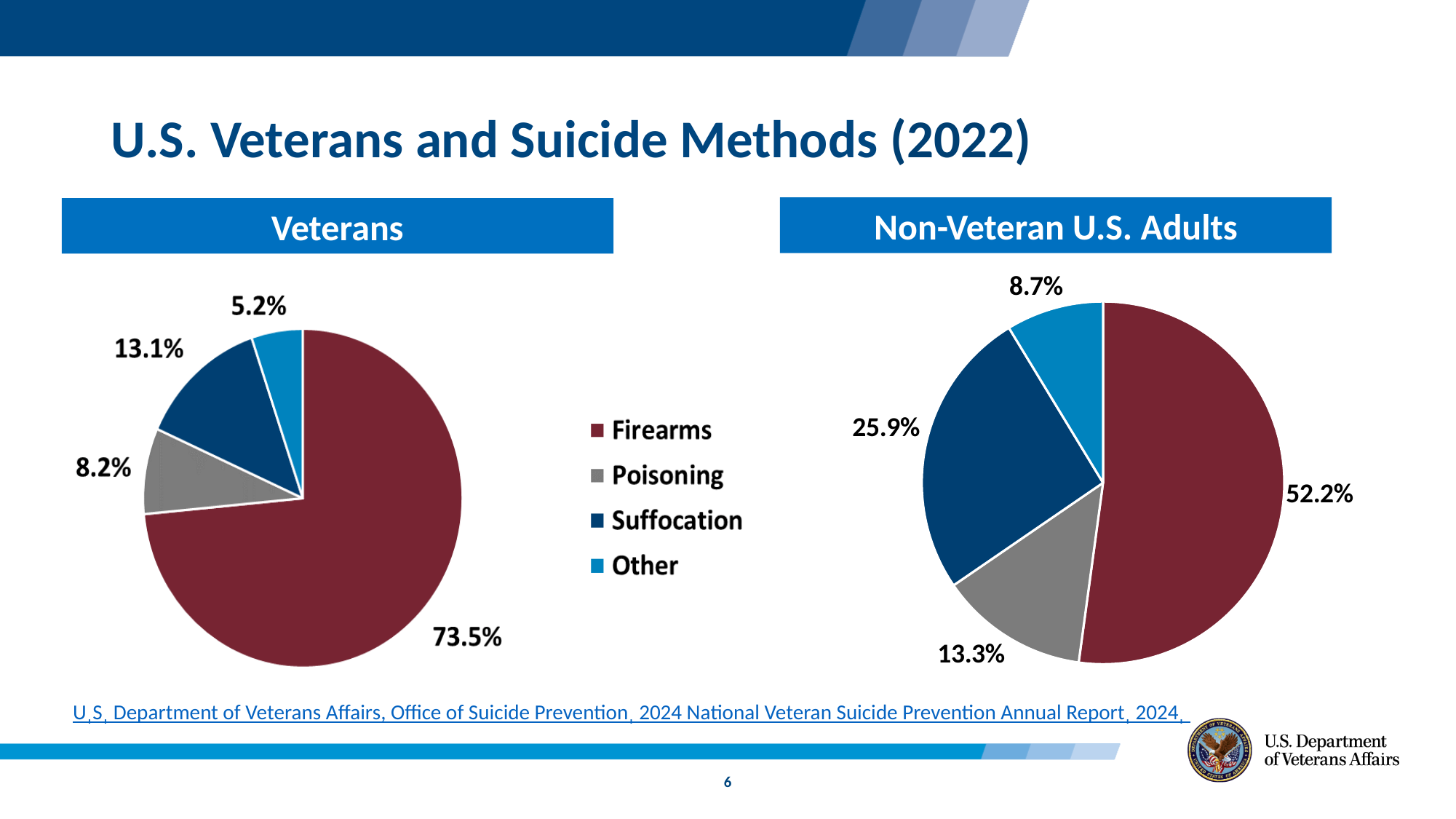
What type of chart is used for the Non-Veteran U.S. Adults data? Pie chart What is the difference between the Firearms share in the Veterans chart and the Firearms share in the Non-Veteran U.S. Adults chart? 21.3% In the Veterans pie chart, which method has the smallest slice? Other Which colour represents Poisoning in the legend? Gray Which is larger: the Suffocation share for Veterans or the Suffocation share for Non-Veteran U.S. Adults? Non-Veteran U.S. Adults How many slices does the Veterans pie chart have? 4 In the Veterans pie chart, what share is Poisoning? 8.2% In the Veterans pie chart, which method has the largest slice? Firearms In the Non-Veteran U.S. Adults pie chart, what share is Other? 8.7% In the Non-Veteran U.S. Adults pie chart, what share is Suffocation? 25.9% In the Veterans pie chart, what share is Firearms? 73.5% In the Non-Veteran U.S. Adults pie chart, which method has the smallest slice? Other